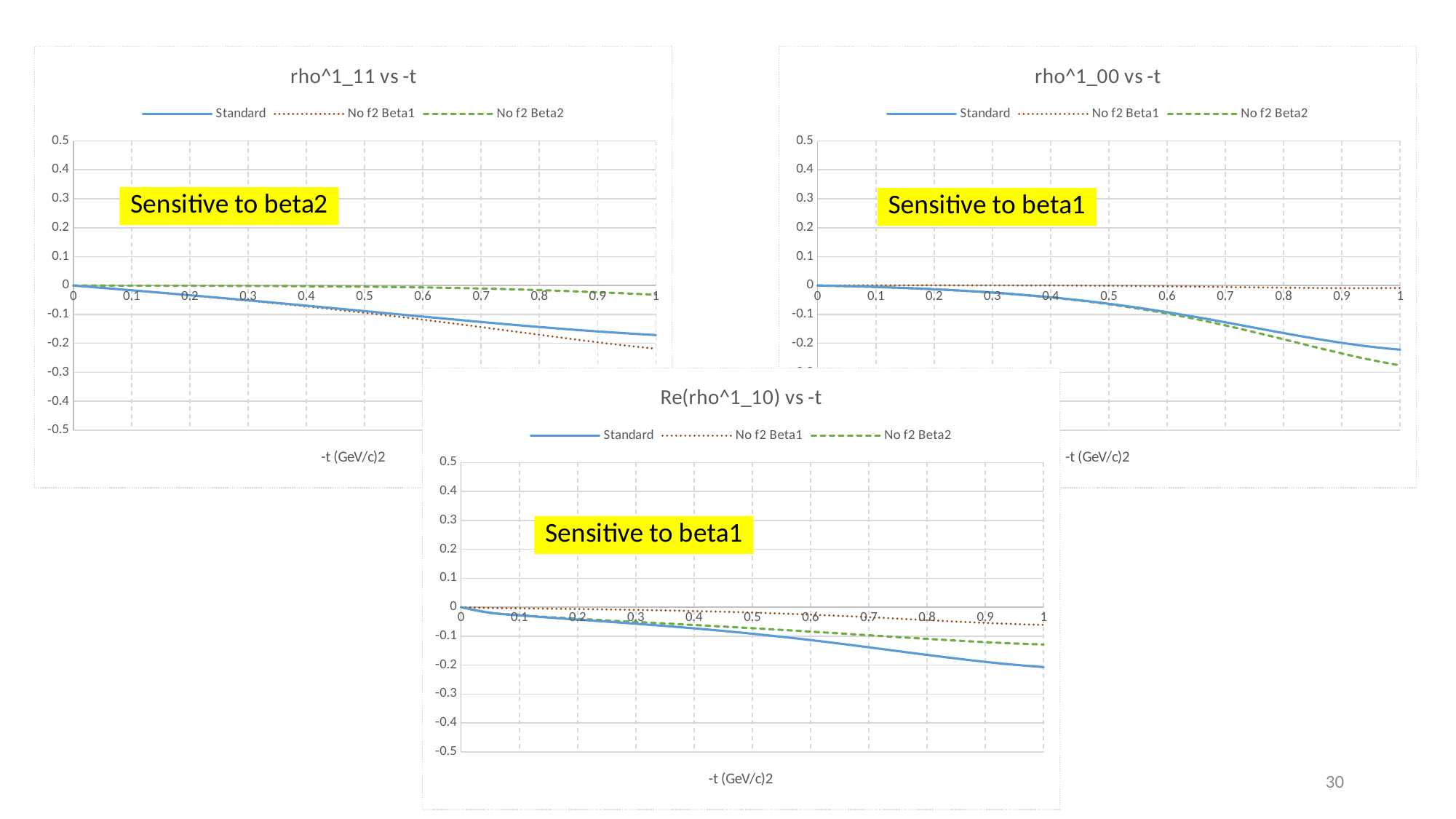
What is the x-axis label of the "Re(rho^1_10) vs -t" chart? -t (GeV/c)2 Which series in "rho^1_00 vs -t" is drawn as a green dashed line? No f2 Beta2 What kind of chart is "rho^1_11 vs -t"? line chart In "rho^1_11 vs -t", at -t = 1, which series is lower: Standard or No f2 Beta1? No f2 Beta1 How many series does the legend of "rho^1_00 vs -t" list? 3 In "rho^1_11 vs -t", does the Standard series rise or fall as -t increases from 0 to 1? fall In "rho^1_00 vs -t", is the No f2 Beta2 value at -t = 1 greater or less than -0.2? less In "rho^1_11 vs -t", is the Standard value at -t = 1 greater or less than -0.1? less In "Re(rho^1_10) vs -t", is the Standard value at -t = 1 greater or less than -0.1? less How many charts are shown on the slide? 3 In "Re(rho^1_10) vs -t", at -t = 1, which series is lowest? Standard In "rho^1_00 vs -t", at -t = 1, which series is higher: No f2 Beta1 or Standard? No f2 Beta1